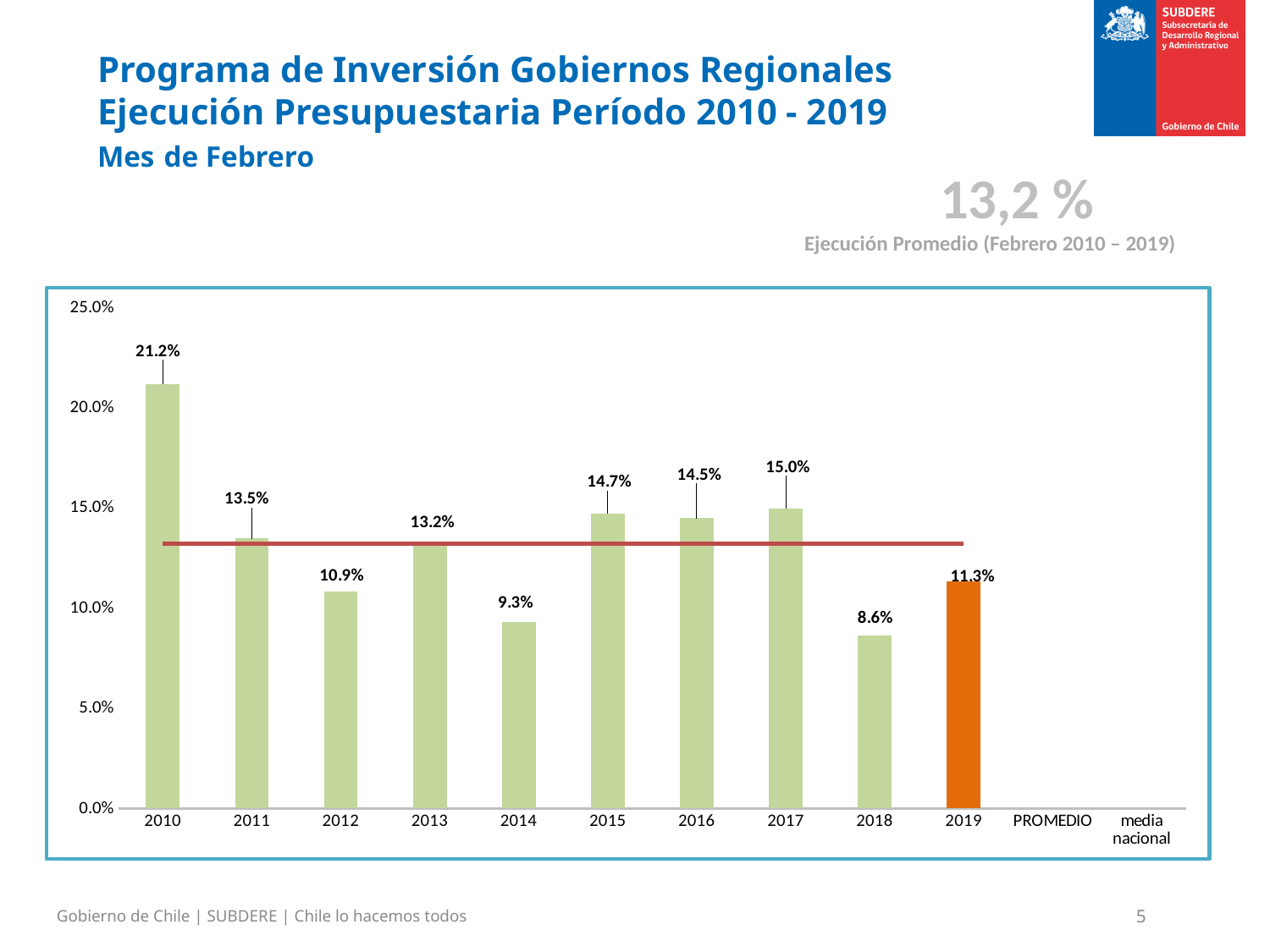
What is the value for 2010? 21.2% Is the value for 2012 greater or less than 10.0%? greater How many years from 2010 to 2019 have bars plotted? 10 Which is larger, the value for 2015 or the value for 2016? 2015 Did the value rise or fall from 2017 to 2018? fall What is the difference between the values for 2010 and 2018? 12.6% Which year has the highest value? 2010 What is the value for 2014? 9.3% What kind of chart is shown? bar chart Which year has the lowest value? 2018 What is the value for 2019? 11.3% Which year's bar is coloured orange instead of green? 2019